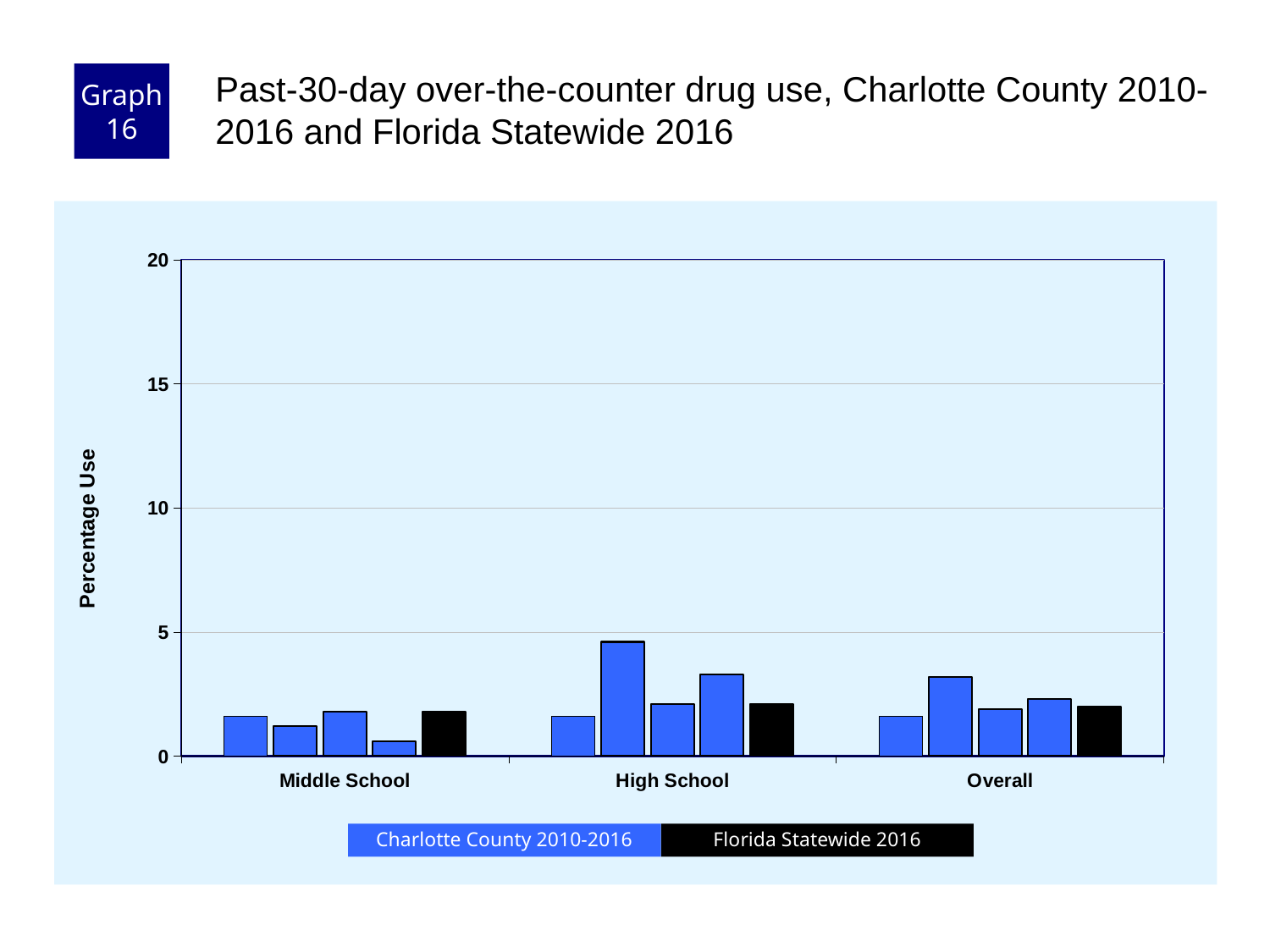
What is the label of the y axis? Percentage Use Which category contains the shortest bar on the chart? Middle School Which category contains the tallest bar on the chart? High School Is the value for Florida Statewide 2016 in the Overall category greater or less than 5? less Is the tallest Charlotte County bar larger in the High School category or in the Middle School category? High School Is the value for Florida Statewide 2016 in the High School category greater or less than 5? less How many categories are shown on the x axis? 3 What kind of chart is shown on the slide? bar chart Is the tallest Charlotte County bar in the High School category greater or less than 5? less What is the title of the chart? Past-30-day over-the-counter drug use, Charlotte County 2010-2016 and Florida Statewide 2016 How many series does the legend list? 2